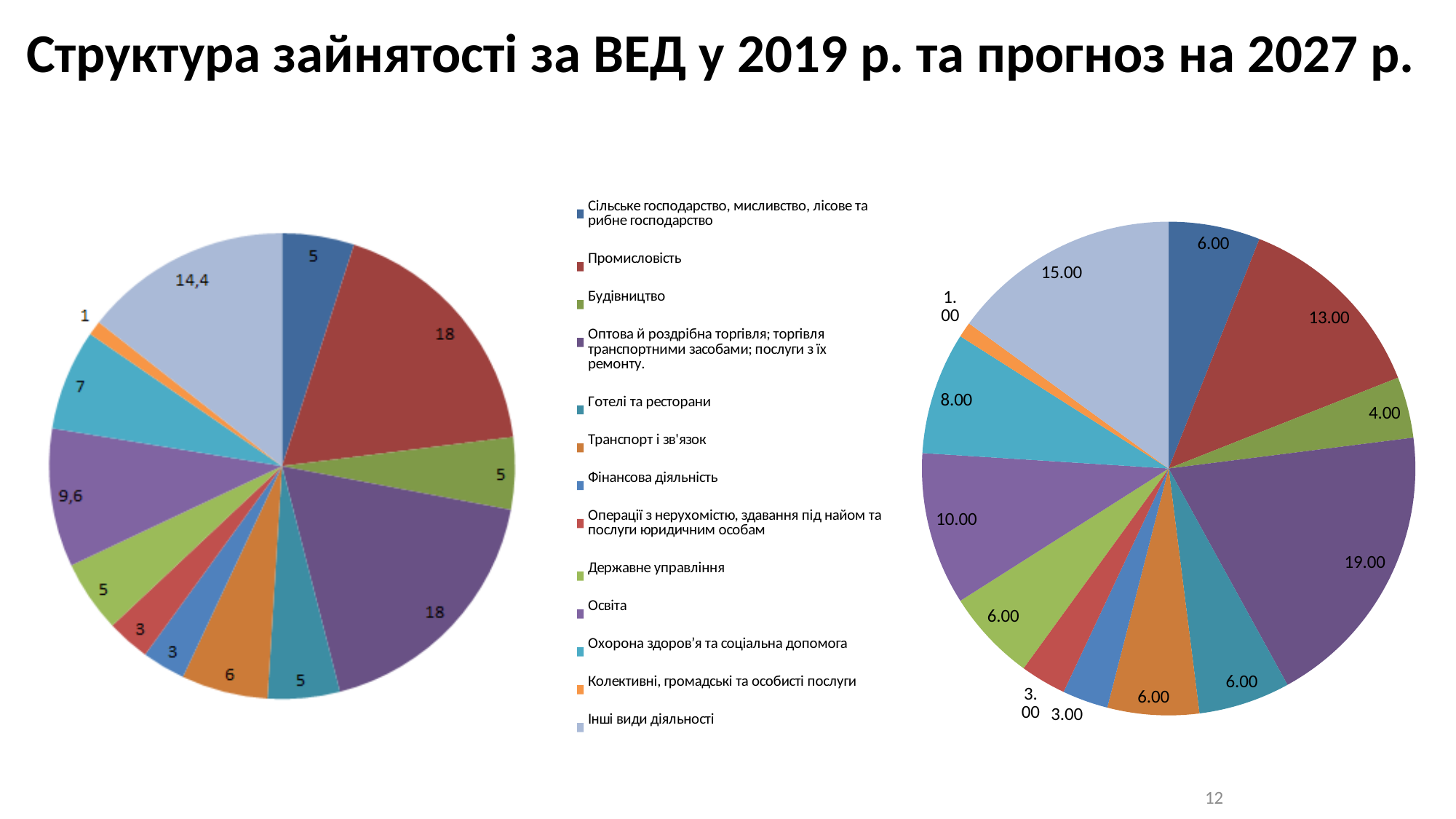
In the right pie chart (2027 forecast), what is the value for Промисловість? 13.00 In the left pie chart (2019), which category has the smallest slice? Колективні, громадські та особисті послуги In the left pie chart (2019), what is the value for Інші види діяльності? 14,4 In the right pie chart (2027 forecast), what is the difference between the values for Інші види діяльності and Охорона здоров'я та соціальна допомога? 7.00 How many categories does the legend list? 13 In the left pie chart (2019), which is larger: the value for Охорона здоров'я та соціальна допомога or the value for Транспорт і зв'язок? Охорона здоров'я та соціальна допомога What type of charts are shown on the slide? Pie charts In the left pie chart (2019), what is the value for Промисловість? 18 In the right pie chart (2027 forecast), which category has the largest slice? Оптова й роздрібна торгівля; торгівля транспортними засобами; послуги з їх ремонту What is the title of the slide? Структура зайнятості за ВЕД у 2019 р. та прогноз на 2027 р. In the left pie chart (2019), what is the value for Освіта? 9,6 In the right pie chart (2027 forecast), what is the value for Оптова й роздрібна торгівля; торгівля транспортними засобами; послуги з їх ремонту? 19.00